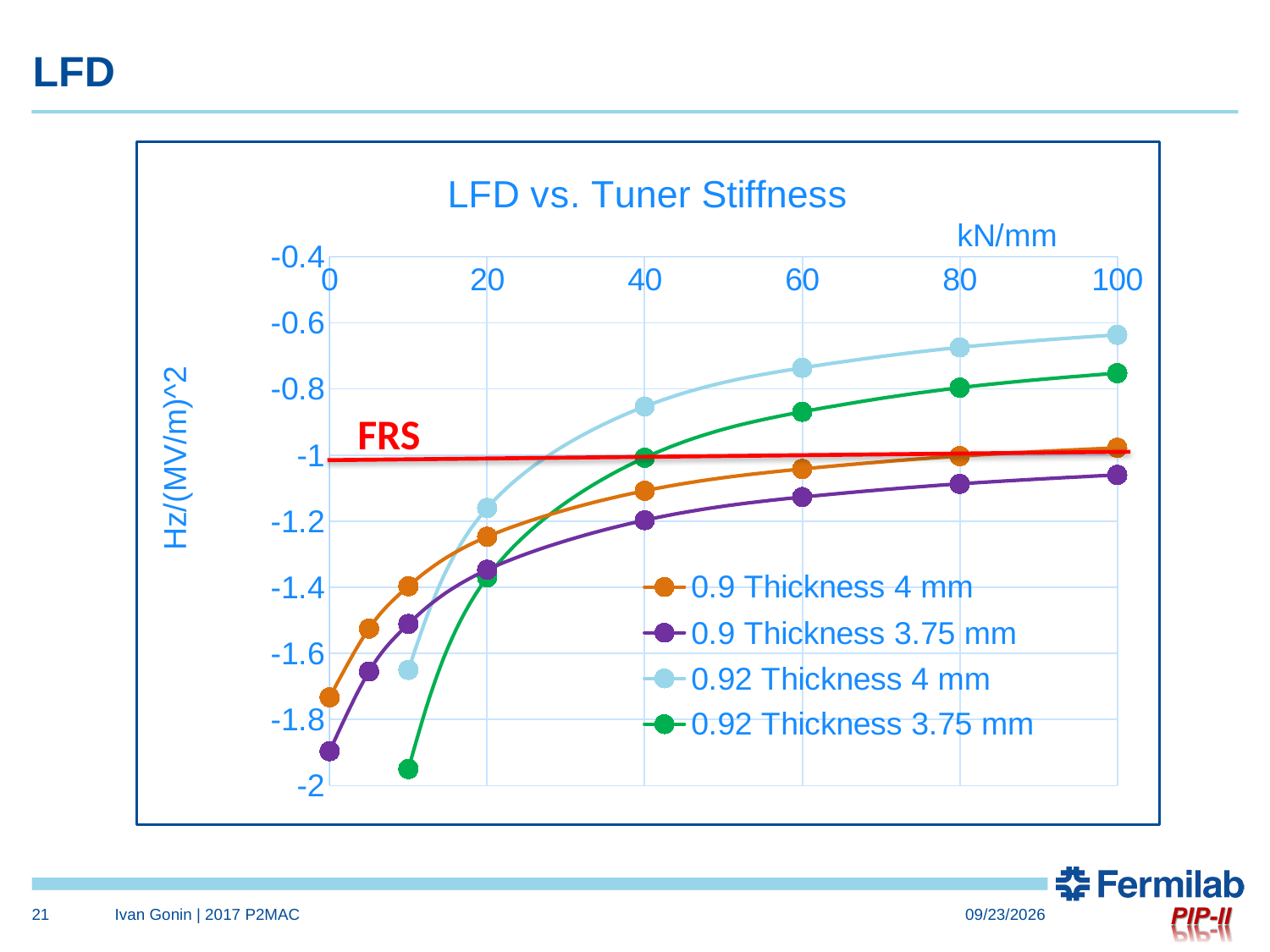
What kind of chart is shown on the slide? line chart Which series has the lowest value at 100 kN/mm? 0.9 Thickness 3.75 mm At 60 kN/mm, which is larger: the value for 0.92 Thickness 4 mm or the value for 0.9 Thickness 3.75 mm? 0.92 Thickness 4 mm How many series does the chart's legend list? 4 What is the title of the chart? LFD vs. Tuner Stiffness Which series has the highest value at 100 kN/mm? 0.92 Thickness 4 mm Is the value for 0.92 Thickness 4 mm at 100 kN/mm greater or less than -0.8? greater Do the values of the 0.92 Thickness 4 mm series rise or fall as tuner stiffness increases along the x axis? rise Is the value for 0.9 Thickness 3.75 mm at 0 kN/mm greater or less than -1.8? less Is the value for 0.9 Thickness 4 mm at 0 kN/mm greater or less than -1.6? less How many data points are plotted for the 0.92 Thickness 4 mm series? 6 What label is written next to the red horizontal line on the chart? FRS